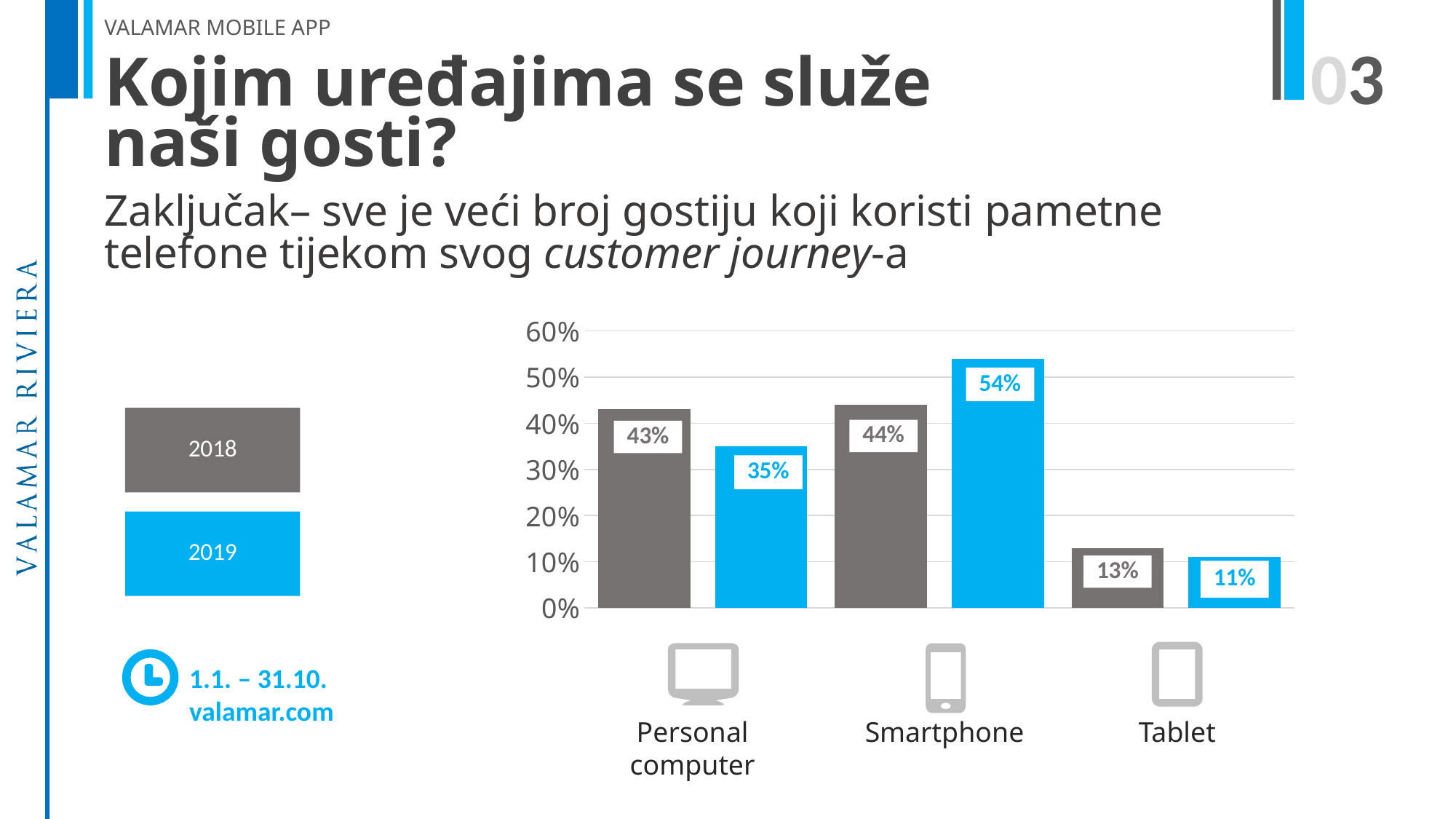
Which colour represents the 2019 series in the chart? Blue What is the value for Personal computer in 2018? 43% Which device category has the lowest value in 2018? Tablet What is the difference between the 2018 and 2019 values for Personal computer? 8% Which device category has the highest value in 2019? Smartphone What is the difference between the 2019 and 2018 values for Smartphone? 10% How many series does the legend list? 2 What is the value for Smartphone in 2019? 54% Which is larger for Personal computer, the 2018 value or the 2019 value? 2018 What kind of chart is shown on the slide? Bar chart What is the value for Tablet in 2019? 11% How many device categories are shown on the x axis? 3